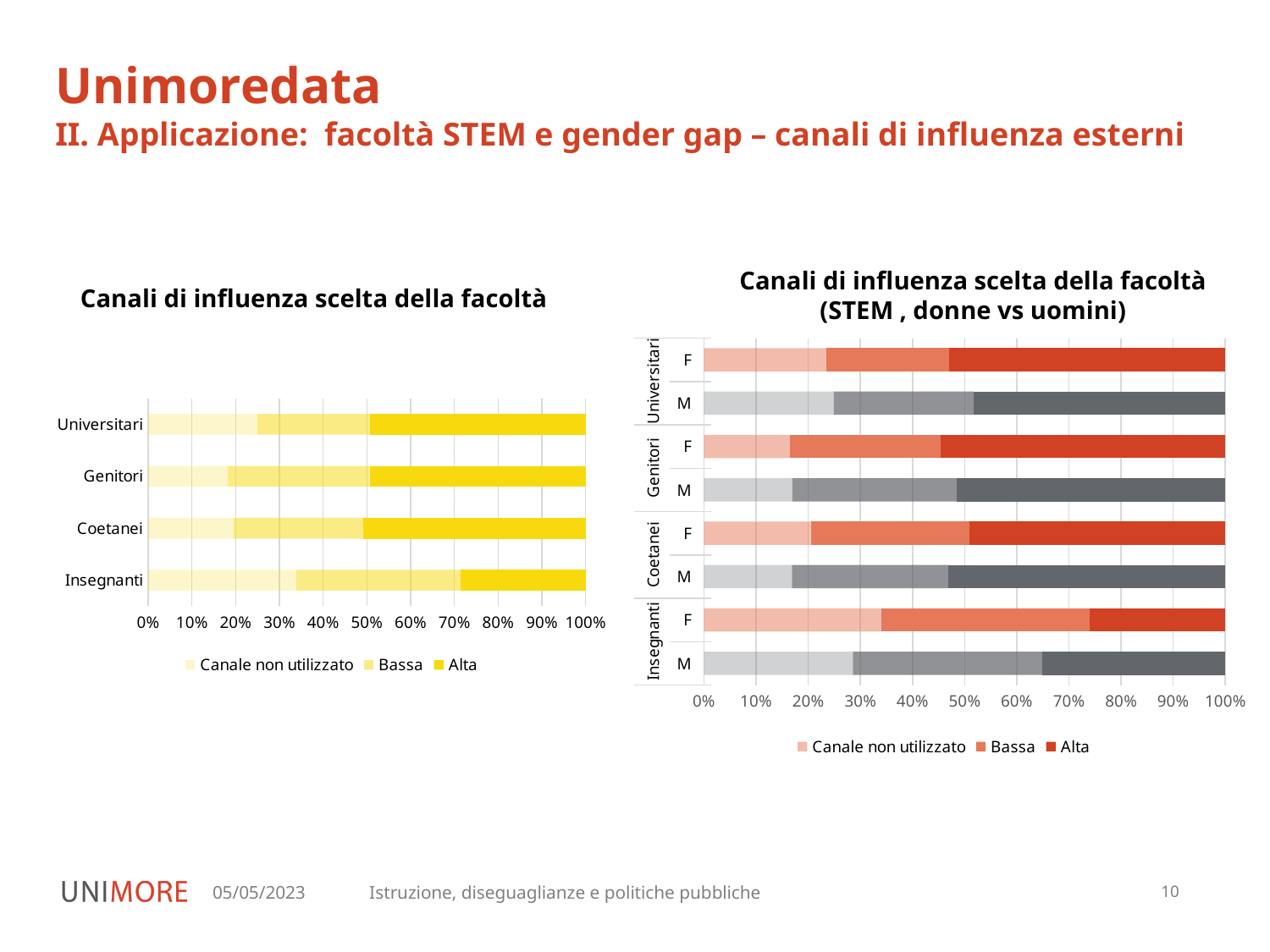
In the left chart 'Canali di influenza scelta della facoltà', which category has the largest 'Canale non utilizzato' share? Insegnanti What are the legend entries of the right chart 'Canali di influenza scelta della facoltà (STEM, donne vs uomini)'? Canale non utilizzato, Bassa, Alta In the left chart 'Canali di influenza scelta della facoltà', how many series does the legend list? 3 In the right chart 'Canali di influenza scelta della facoltà (STEM, donne vs uomini)', how many bars are plotted? 8 In the right chart 'Canali di influenza scelta della facoltà (STEM, donne vs uomini)', how many series does the legend list? 3 What type of chart is the left chart titled 'Canali di influenza scelta della facoltà'? bar chart In the left chart 'Canali di influenza scelta della facoltà', how many categories are shown on the vertical axis? 4 In the left chart 'Canali di influenza scelta della facoltà', is the 'Canale non utilizzato' share for Insegnanti greater or less than 30%? greater In the left chart 'Canali di influenza scelta della facoltà', is the 'Alta' share for Universitari greater or less than 40%? greater In the right chart 'Canali di influenza scelta della facoltà (STEM, donne vs uomini)', which has the larger 'Alta' share for Insegnanti: F or M? M In the left chart 'Canali di influenza scelta della facoltà', which category has the smallest 'Alta' share? Insegnanti In the right chart 'Canali di influenza scelta della facoltà (STEM, donne vs uomini)', is the 'Alta' share for Insegnanti M greater or less than 50%? less